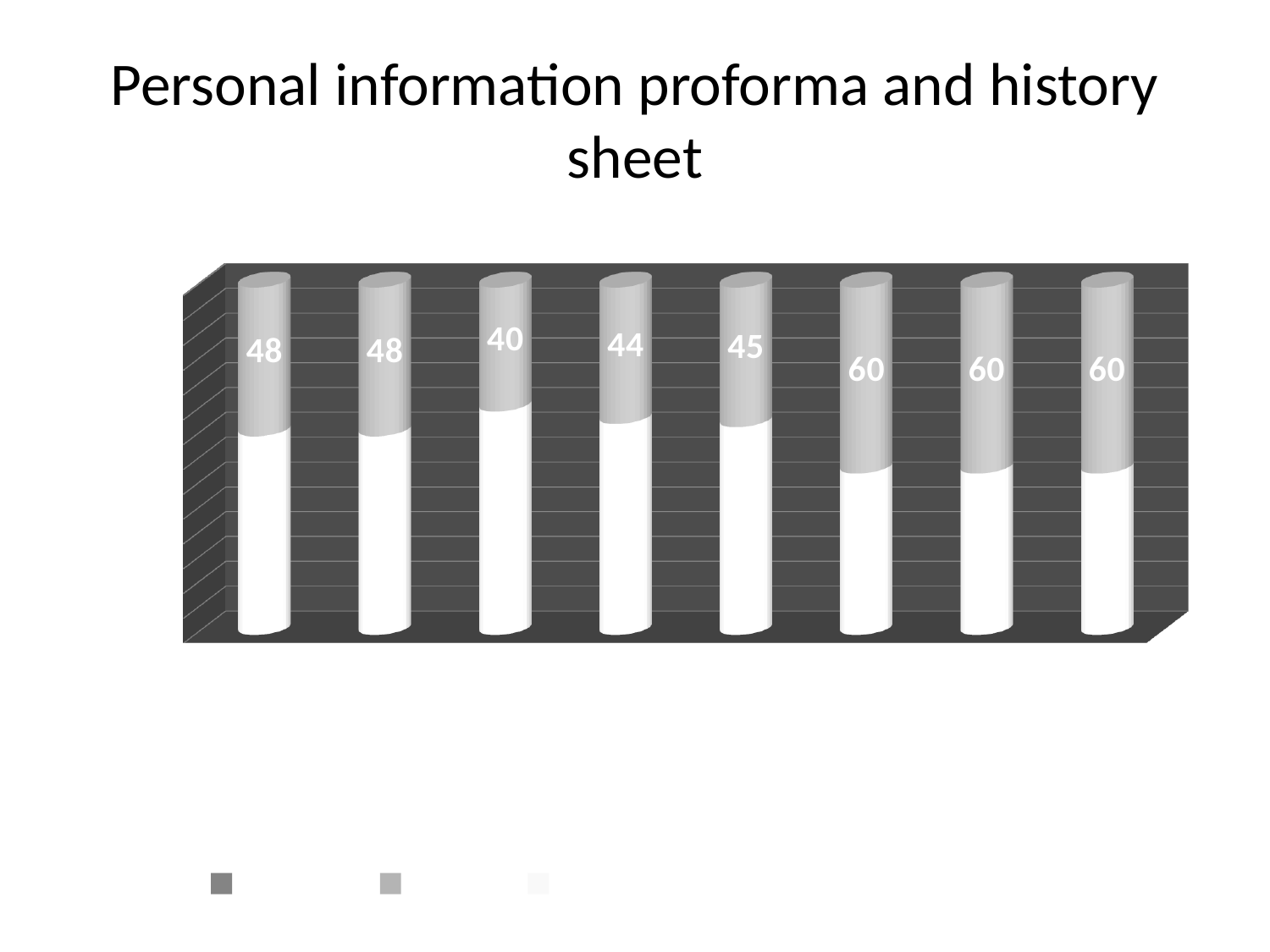
What value is labelled on the fourth bar from the left? 44 How many entries does the legend show? 3 What is the title of the slide containing the chart? Personal information proforma and history sheet How many bars are plotted in the chart? 8 What value is labelled on the fifth bar from the left? 45 What value is labelled on the third bar from the left? 40 What value is labelled on the last bar on the right? 60 What value is labelled on the first bar from the left? 48 What kind of chart is shown on the slide? bar chart What is the difference between the labelled value on the first bar (48) and the third bar (40)? 8 What is the lowest value labelled on any bar in the chart? 40 What is the highest value labelled on any bar in the chart? 60